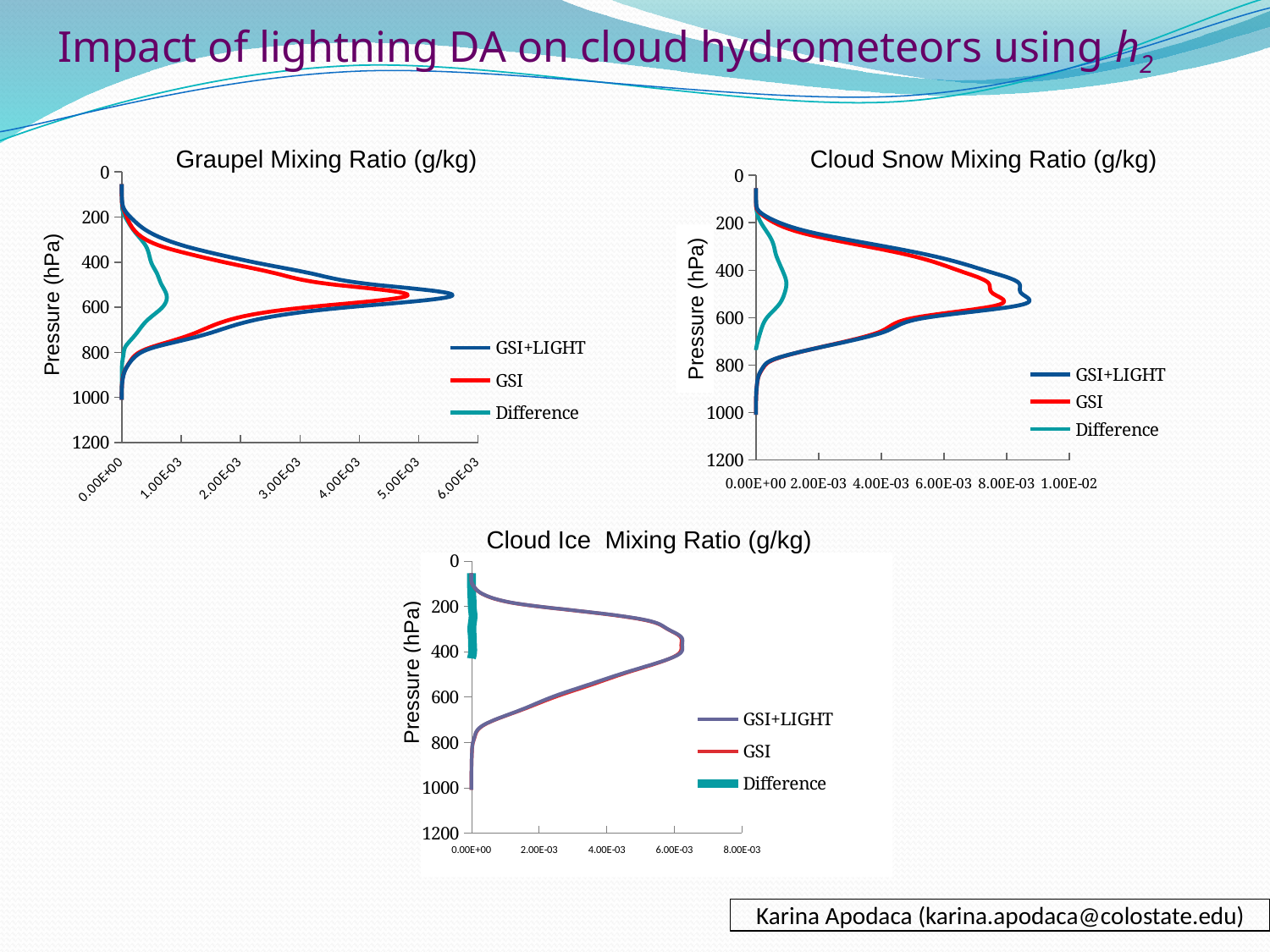
In the Cloud Snow Mixing Ratio (g/kg) chart, is the peak value of the Difference series greater or less than 2.00E-03? less What is the label of the vertical axis on the Cloud Ice Mixing Ratio (g/kg) chart? Pressure (hPa) In the Graupel Mixing Ratio (g/kg) chart, which series reaches a larger peak value, GSI+LIGHT or GSI? GSI+LIGHT In the Graupel Mixing Ratio (g/kg) chart, is the peak value of the Difference series greater or less than 1.00E-03? less How many series does the legend of the Cloud Snow Mixing Ratio (g/kg) chart list? 3 In the Cloud Snow Mixing Ratio (g/kg) chart, is the peak value of the GSI+LIGHT series greater or less than 8.00E-03? greater How many charts are shown on the slide? 3 What kind of chart is the Graupel Mixing Ratio (g/kg) chart? line chart In the Cloud Snow Mixing Ratio (g/kg) chart, which series reaches a larger peak value, GSI+LIGHT or GSI? GSI+LIGHT What are the three legend entries in the Graupel Mixing Ratio (g/kg) chart? GSI+LIGHT, GSI, Difference